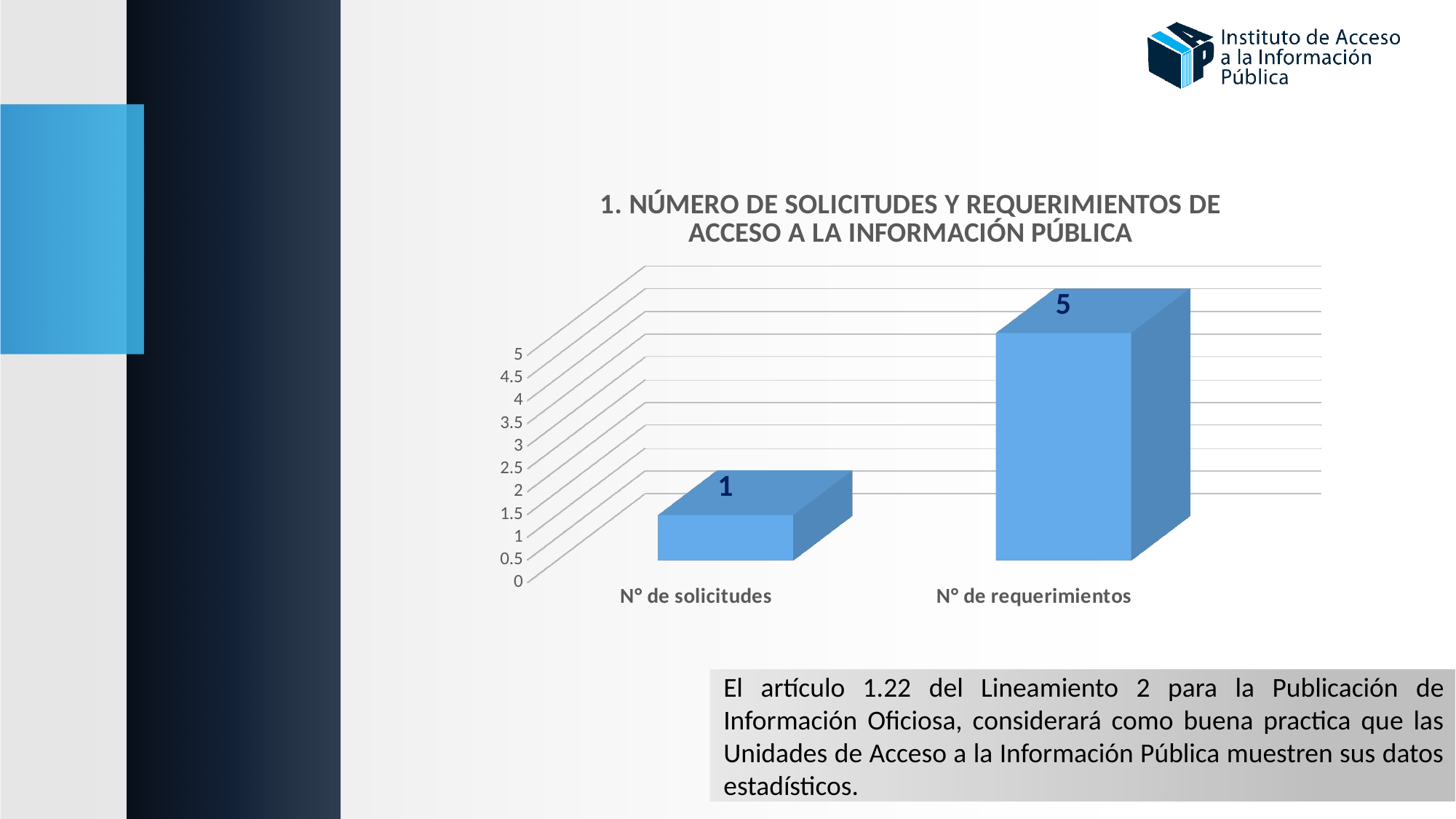
Is the value for N° de requerimientos greater or less than 3? greater How many categories are shown on the x axis? 2 What kind of chart is shown on the slide? Bar chart What is the title of the chart? 1. NÚMERO DE SOLICITUDES Y REQUERIMIENTOS DE ACCESO A LA INFORMACIÓN PÚBLICA What is the value for N° de requerimientos? 5 Which category has the lowest value? N° de solicitudes What is the value for N° de solicitudes? 1 Which is larger, the value for N° de solicitudes or the value for N° de requerimientos? N° de requerimientos What is the difference between the values for N° de requerimientos and N° de solicitudes? 4 Which category has the highest value? N° de requerimientos Is the value for N° de solicitudes greater or less than 2? less What is the maximum value shown on the vertical axis? 5